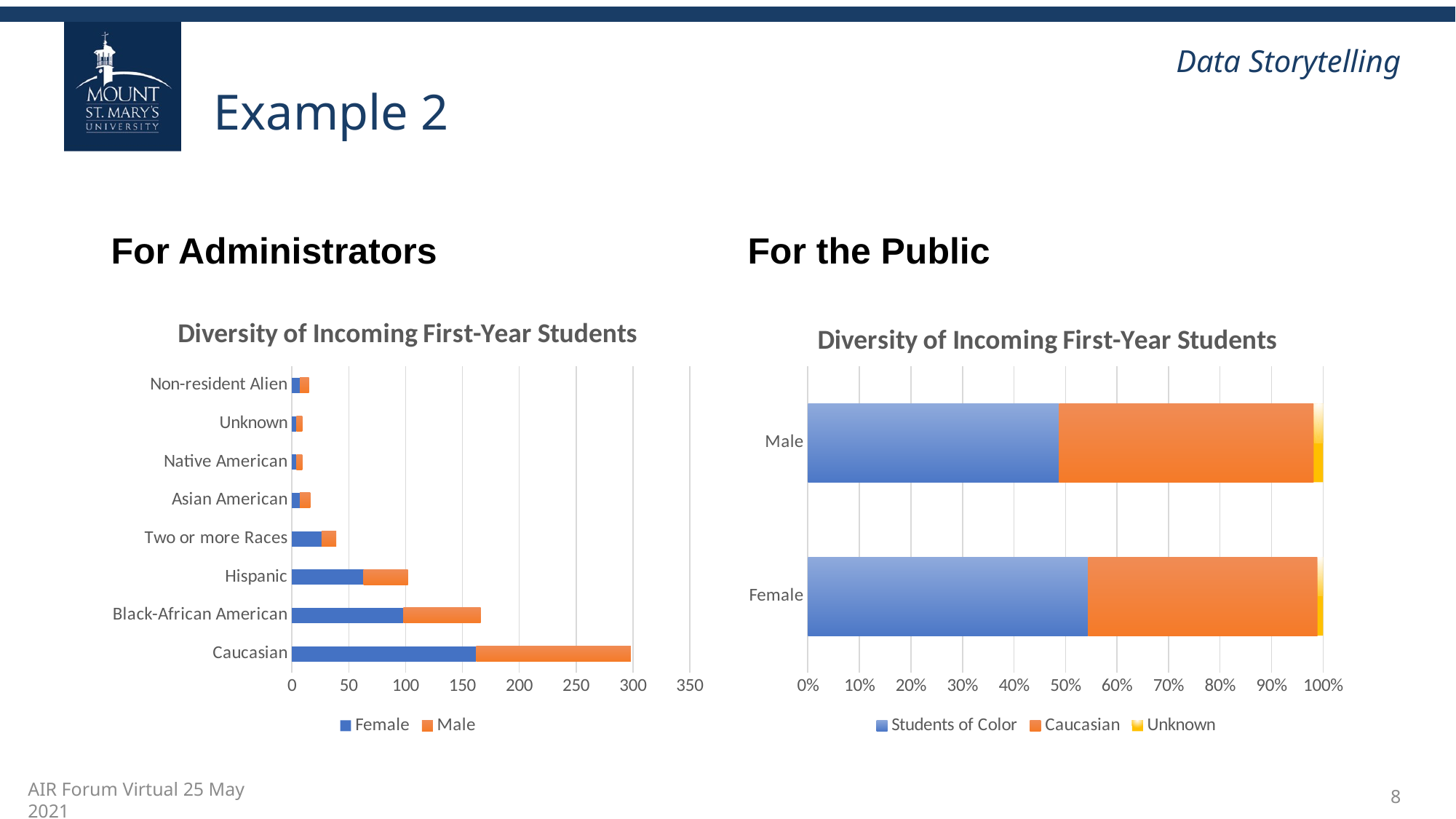
In the left chart under 'For Administrators', is the total bar for Caucasian greater or less than 250? greater In the left chart under 'For Administrators', is the Female value for Caucasian greater or less than 150? greater How many race/ethnicity categories does the left chart under 'For Administrators' show? 8 In the left chart under 'For Administrators', which has the longer total bar, Hispanic or Two or more Races? Hispanic What are the legend entries of the right chart under 'For the Public'? Students of Color, Caucasian, Unknown What kind of chart is the right chart under 'For the Public'? bar chart How many series does the legend of the left chart under 'For Administrators' list? 2 In the left chart under 'For Administrators', is the total bar for Hispanic greater or less than 150? less In the left chart under 'For Administrators', which category has the longest total bar? Caucasian What kind of chart is the left chart under 'For Administrators'? bar chart How many series does the legend of the right chart under 'For the Public' list? 3